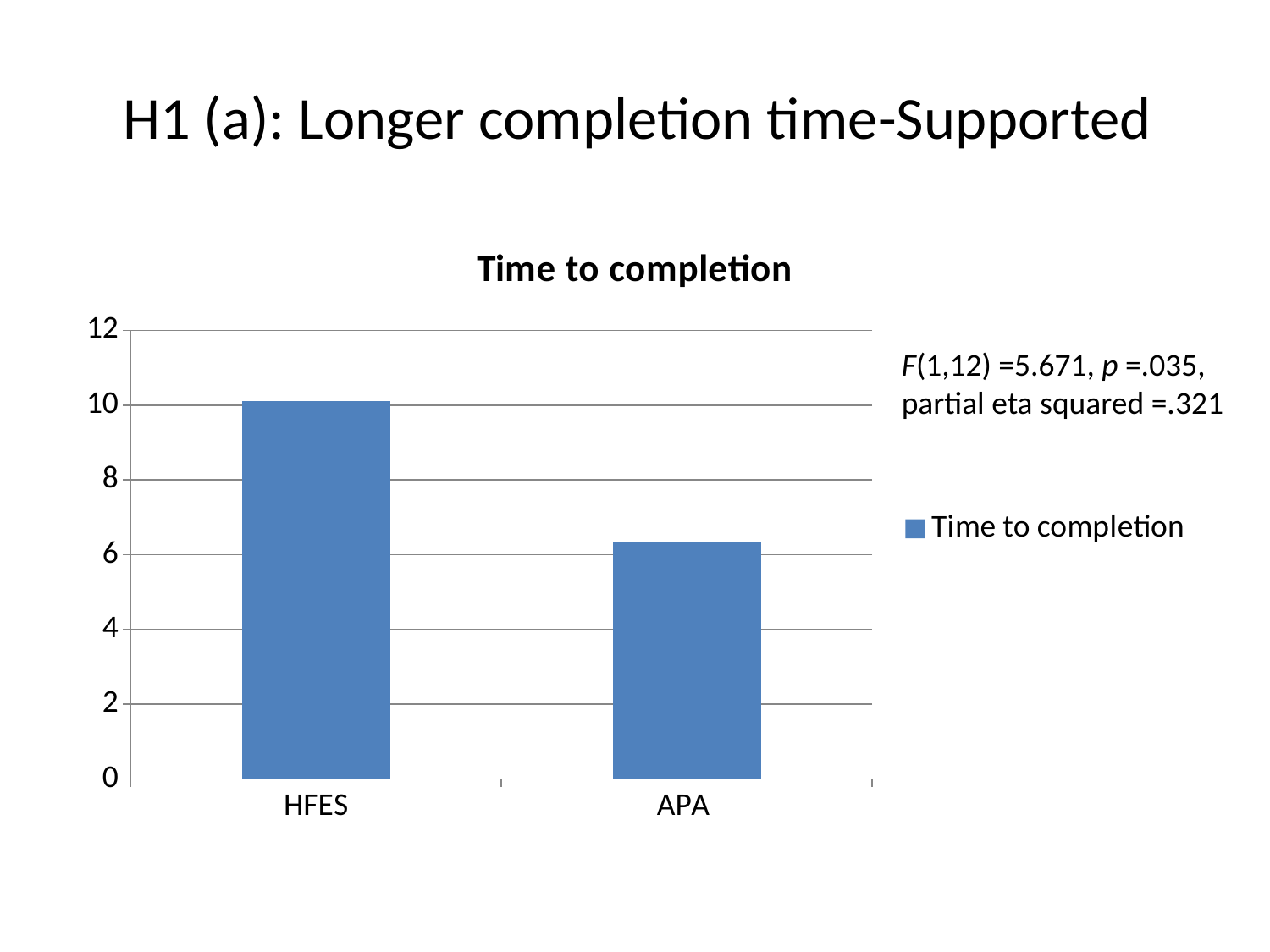
Which has a larger time to completion, HFES or APA? HFES Is the value for APA greater or less than 8? less Which category has the lowest time to completion? APA How many series does the chart legend list? 1 How many categories are shown on the x axis of the chart? 2 Is the value for HFES greater or less than 12? less What is the title of the chart? Time to completion Which category has the highest time to completion? HFES What is the name of the series shown in the chart legend? Time to completion What kind of chart is shown on the slide? bar chart Is the value for HFES greater or less than 8? greater